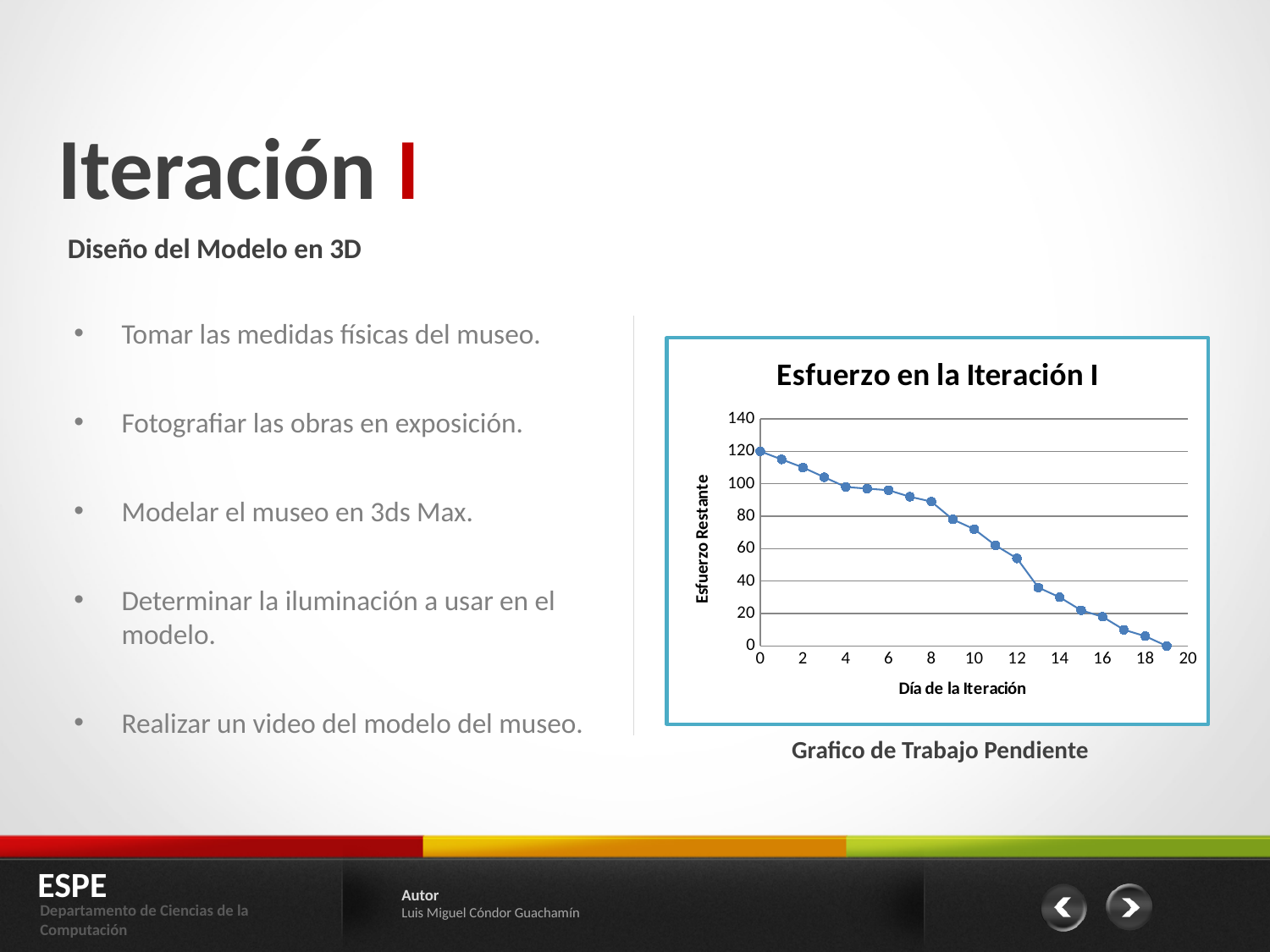
What kind of chart is shown on the slide? line chart On which day of the iteration is the Esfuerzo Restante highest? 0 What is the value of Esfuerzo Restante on day 0 of the iteration? 120 Is the value for day 2 greater or less than 100? greater Is the value for day 5 greater or less than 80? greater Is the value for day 10 greater or less than 80? less What is the label of the y axis of the chart? Esfuerzo Restante Which has the larger Esfuerzo Restante, day 4 or day 14? day 4 Do the values in the chart rise or fall as the day of the iteration increases? fall What is the title of the chart? Esfuerzo en la Iteración I